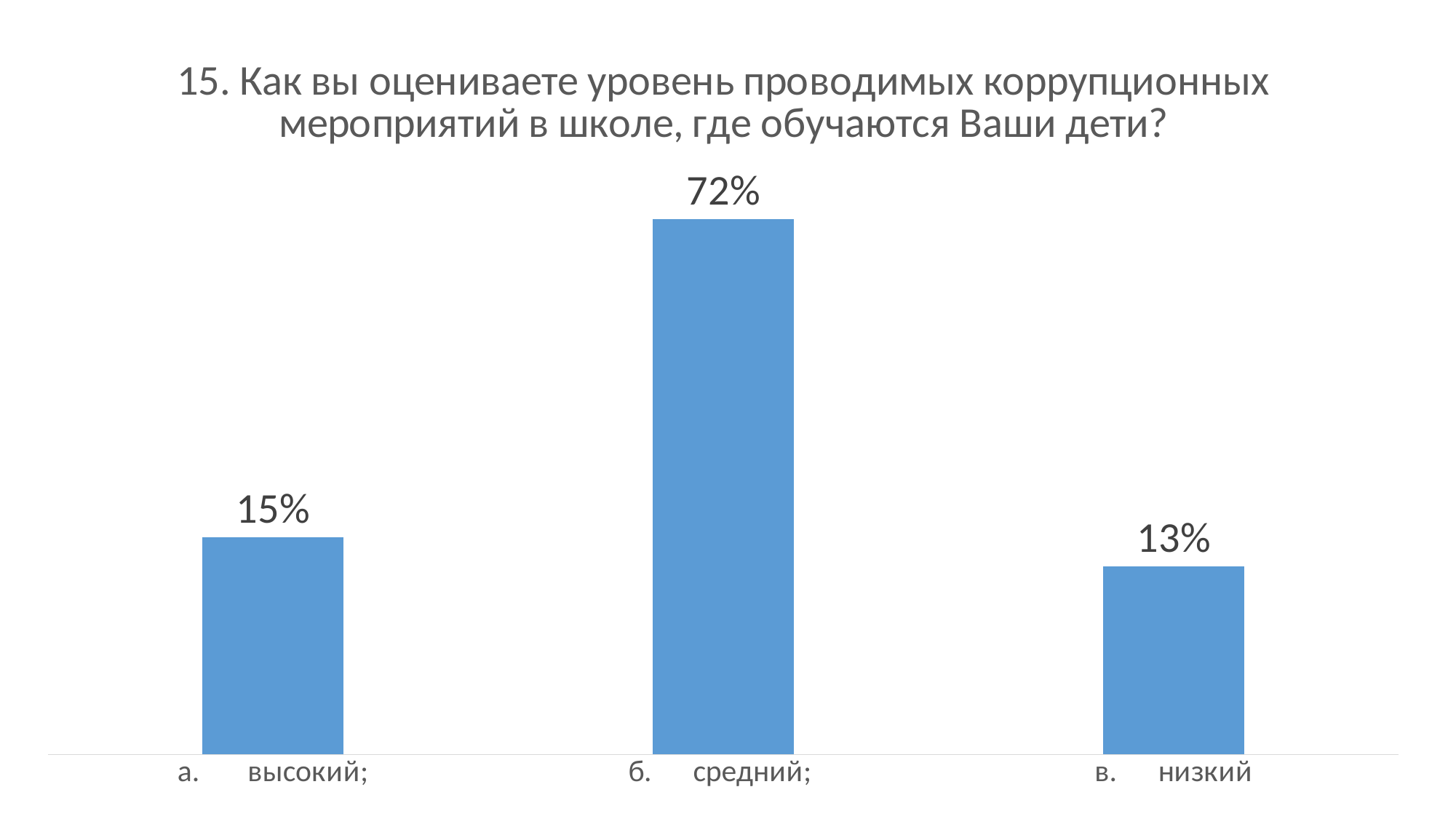
What is the value for "высокий"? 15% Which is larger, the value for "средний" or the value for "низкий"? средний What is the value for "средний"? 72% What colour are the bars in the chart? blue What is the total of the three values shown in the chart? 100% What is the difference between the values for "средний" and "высокий"? 57% How many categories are shown in the chart? 3 Which category has the lowest value? низкий What kind of chart is shown on the slide? bar chart What is the value for "низкий"? 13% Which category has the highest value? средний What is the difference between the values for "высокий" and "низкий"? 2%